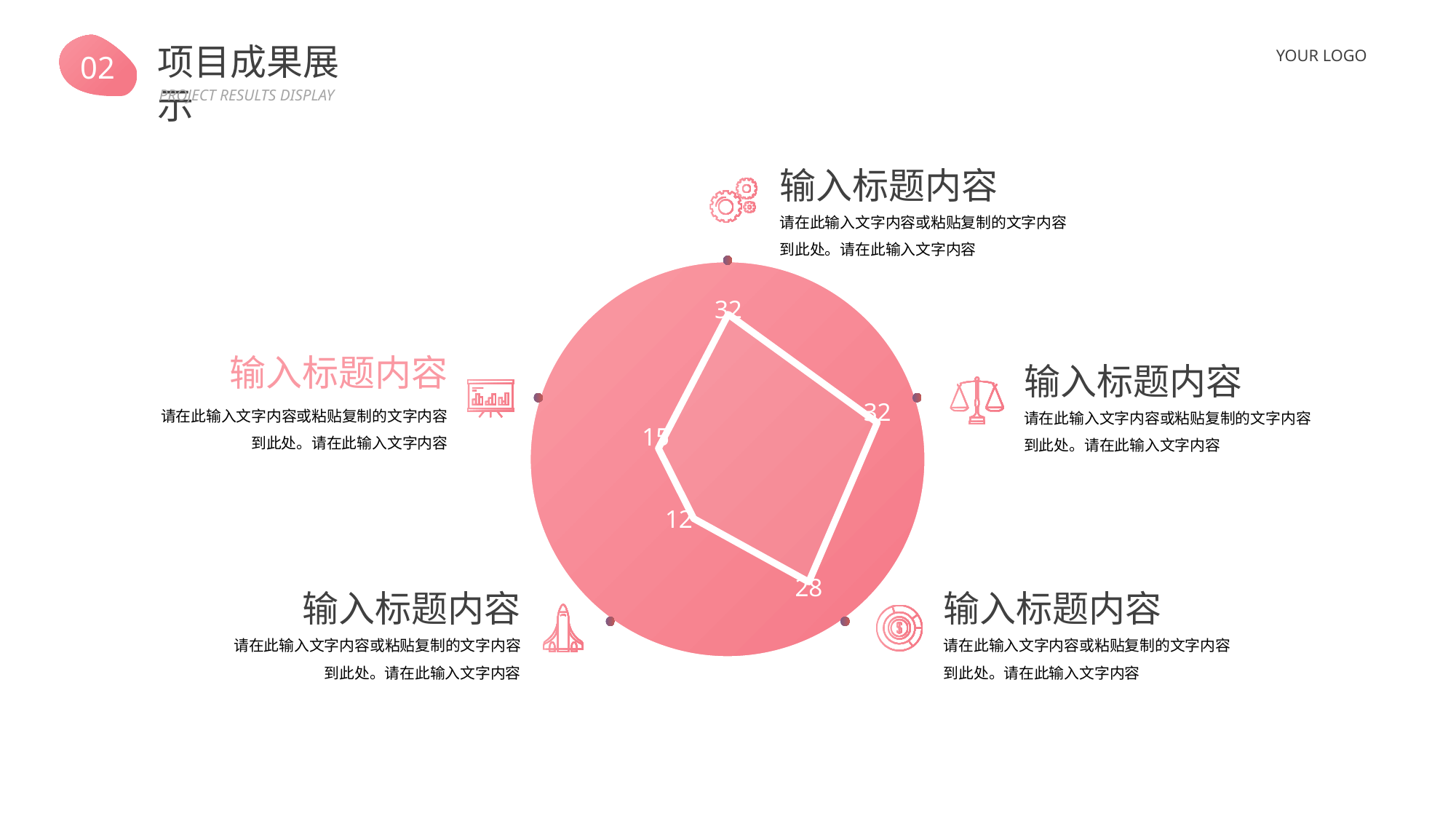
What is the value of the leftmost point on the radar chart? 15 What is the value of the lower-left point on the radar chart? 12 What is the value of the rightmost point on the radar chart? 32 What kind of chart is shown in the centre of the slide? radar chart What is the value of the lower-right point on the radar chart? 28 What is the highest value shown on the radar chart? 32 What is the value of the topmost point on the radar chart? 32 How many data points does the radar chart have? 5 What is the difference between the topmost point (32) and the lower-left point (12) on the radar chart? 20 Which is larger on the radar chart, the lower-right point or the leftmost point? the lower-right point What is the lowest value shown on the radar chart? 12 What colour is the circular background of the radar chart? pink